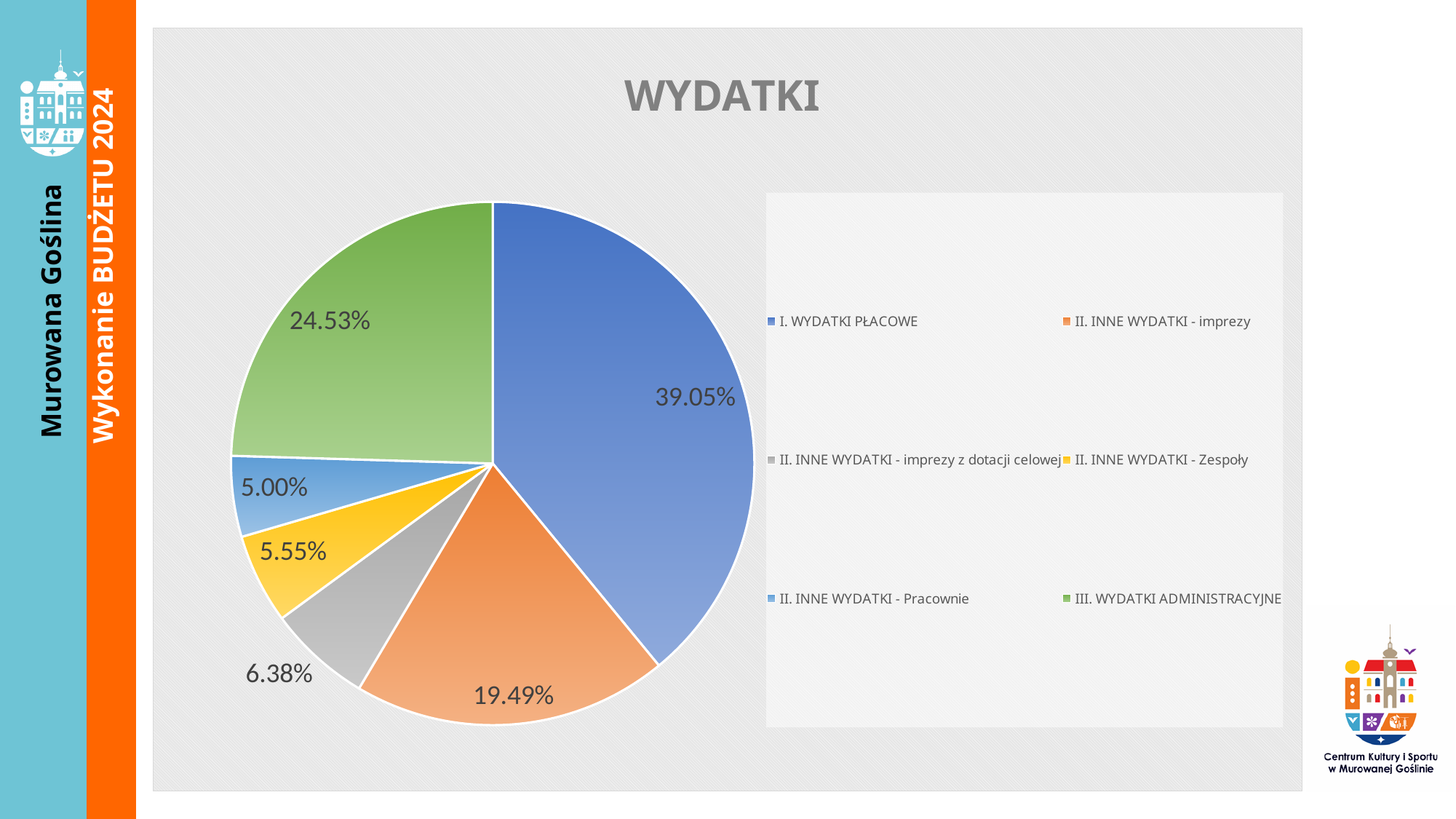
What is the difference between the shares of I. WYDATKI PŁACOWE and III. WYDATKI ADMINISTRACYJNE? 14.52% Which is larger, the share of II. INNE WYDATKI - Zespoły or II. INNE WYDATKI - imprezy z dotacji celowej? II. INNE WYDATKI - imprezy z dotacji celowej What share of the pie does II. INNE WYDATKI - imprezy have? 19.49% What share of the pie does I. WYDATKI PŁACOWE have? 39.05% What is the title of the chart? WYDATKI What type of chart is shown on the slide? pie chart What colour is the slice for III. WYDATKI ADMINISTRACYJNE? green Which category has the smallest slice of the pie? II. INNE WYDATKI - Pracownie Which category has the largest slice of the pie? I. WYDATKI PŁACOWE What share of the pie does II. INNE WYDATKI - Pracownie have? 5.00% How many slices does the pie chart have? 6 What share of the pie does III. WYDATKI ADMINISTRACYJNE have? 24.53%